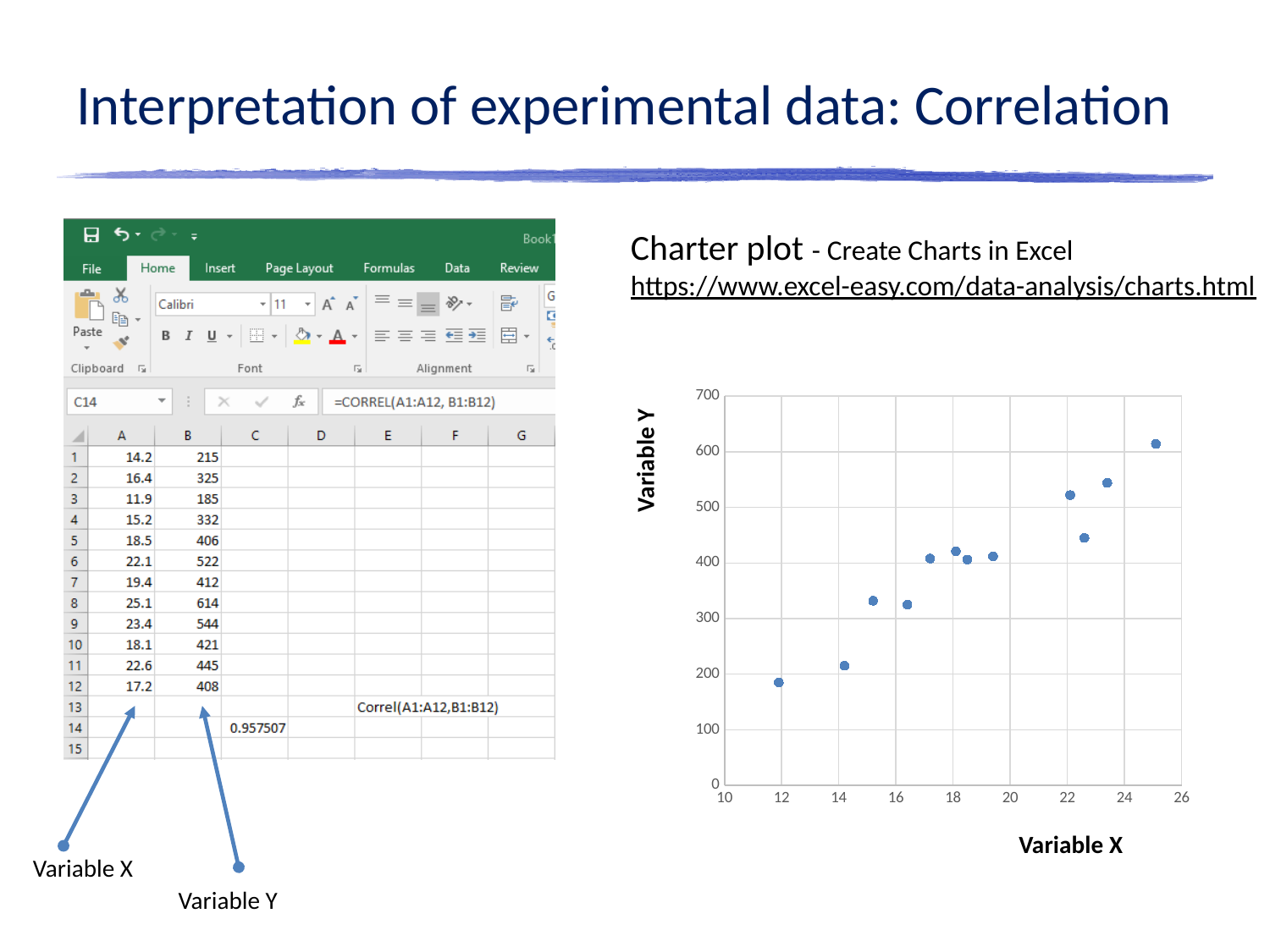
Is the Variable Y value of the leftmost point (near x = 12) greater or less than 200? less What is the title of the vertical axis of the scatter chart? Variable Y Which point has the higher Variable Y value: the point near x = 25 or the point near x = 12? the point near x = 25 How many data points are plotted in the scatter chart? 12 Do the values of Variable Y generally rise or fall as Variable X increases? rise What kind of chart is shown on the right of the slide? scatter plot How many points in the scatter chart have a Variable Y value above 500? 3 How many points in the scatter chart have a Variable Y value below 300? 2 What is the title of the horizontal axis of the scatter chart? Variable X Is the Variable Y value of the point near x = 14 greater or less than 300? less Is the Variable Y value of the rightmost point (near x = 25) greater or less than 600? greater